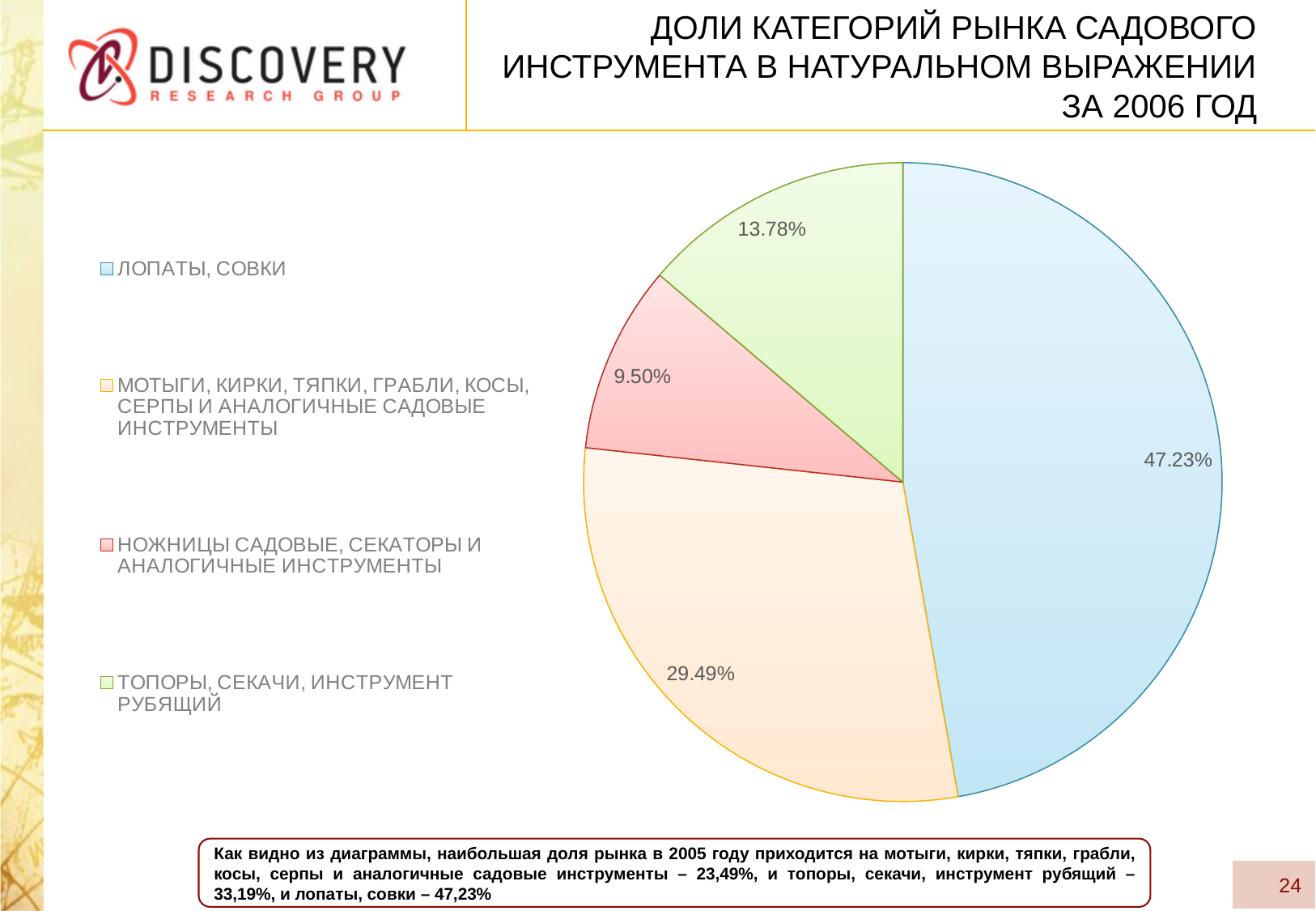
What share of the pie does the slice for ЛОПАТЫ, СОВКИ have? 47.23% What is the value shown for МОТЫГИ, КИРКИ, ТЯПКИ, ГРАБЛИ, КОСЫ, СЕРПЫ И АНАЛОГИЧНЫЕ САДОВЫЕ ИНСТРУМЕНТЫ? 29.49% What colour is the slice for ЛОПАТЫ, СОВКИ? Light blue Which category has the largest share of the pie? ЛОПАТЫ, СОВКИ What is the value shown for ТОПОРЫ, СЕКАЧИ, ИНСТРУМЕНТ РУБЯЩИЙ? 13.78% How many categories are shown in the pie chart? 4 What is the difference in percentage points between the share for ЛОПАТЫ, СОВКИ and the share for МОТЫГИ, КИРКИ, ТЯПКИ, ГРАБЛИ, КОСЫ, СЕРПЫ И АНАЛОГИЧНЫЕ САДОВЫЕ ИНСТРУМЕНТЫ? 17.74 What is the value shown for НОЖНИЦЫ САДОВЫЕ, СЕКАТОРЫ И АНАЛОГИЧНЫЕ ИНСТРУМЕНТЫ? 9.50% Which is larger: the share for ТОПОРЫ, СЕКАЧИ, ИНСТРУМЕНТ РУБЯЩИЙ or the share for НОЖНИЦЫ САДОВЫЕ, СЕКАТОРЫ И АНАЛОГИЧНЫЕ ИНСТРУМЕНТЫ? ТОПОРЫ, СЕКАЧИ, ИНСТРУМЕНТ РУБЯЩИЙ What is the difference in percentage points between the share for ТОПОРЫ, СЕКАЧИ, ИНСТРУМЕНТ РУБЯЩИЙ and the share for НОЖНИЦЫ САДОВЫЕ, СЕКАТОРЫ И АНАЛОГИЧНЫЕ ИНСТРУМЕНТЫ? 4.28 Which category has the smallest share of the pie? НОЖНИЦЫ САДОВЫЕ, СЕКАТОРЫ И АНАЛОГИЧНЫЕ ИНСТРУМЕНТЫ What kind of chart is shown on the slide? Pie chart